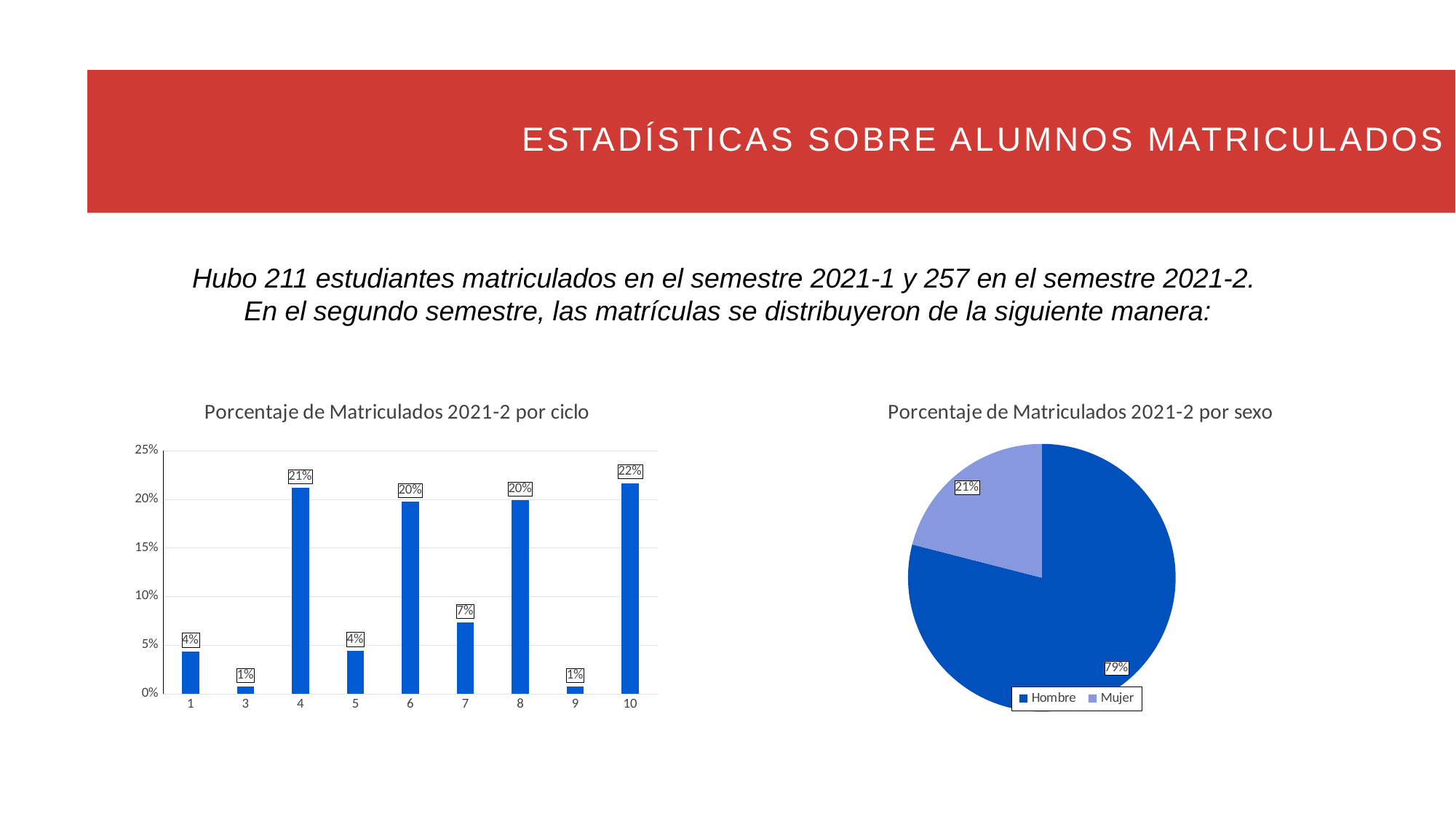
How many entries does the legend of the chart 'Porcentaje de Matriculados 2021-2 por sexo' list? 2 In the chart 'Porcentaje de Matriculados 2021-2 por ciclo', how many ciclos are shown on the x axis? 9 In the chart 'Porcentaje de Matriculados 2021-2 por ciclo', what is the value for ciclo 7? 7% What kind of chart is 'Porcentaje de Matriculados 2021-2 por sexo'? pie chart In the chart 'Porcentaje de Matriculados 2021-2 por ciclo', which ciclo has the highest percentage? 10 In the chart 'Porcentaje de Matriculados 2021-2 por sexo', what share of the pie is Hombre? 79% In the chart 'Porcentaje de Matriculados 2021-2 por ciclo', what is the difference between the values for ciclo 10 and ciclo 7? 15% In the chart 'Porcentaje de Matriculados 2021-2 por ciclo', what is the value for ciclo 4? 21% In the chart 'Porcentaje de Matriculados 2021-2 por ciclo', which is larger, the value for ciclo 6 or the value for ciclo 5? ciclo 6 What kind of chart is 'Porcentaje de Matriculados 2021-2 por ciclo'? bar chart In the chart 'Porcentaje de Matriculados 2021-2 por ciclo', is the value for ciclo 8 greater or less than 15%? greater In the chart 'Porcentaje de Matriculados 2021-2 por sexo', what share of the pie is Mujer? 21%